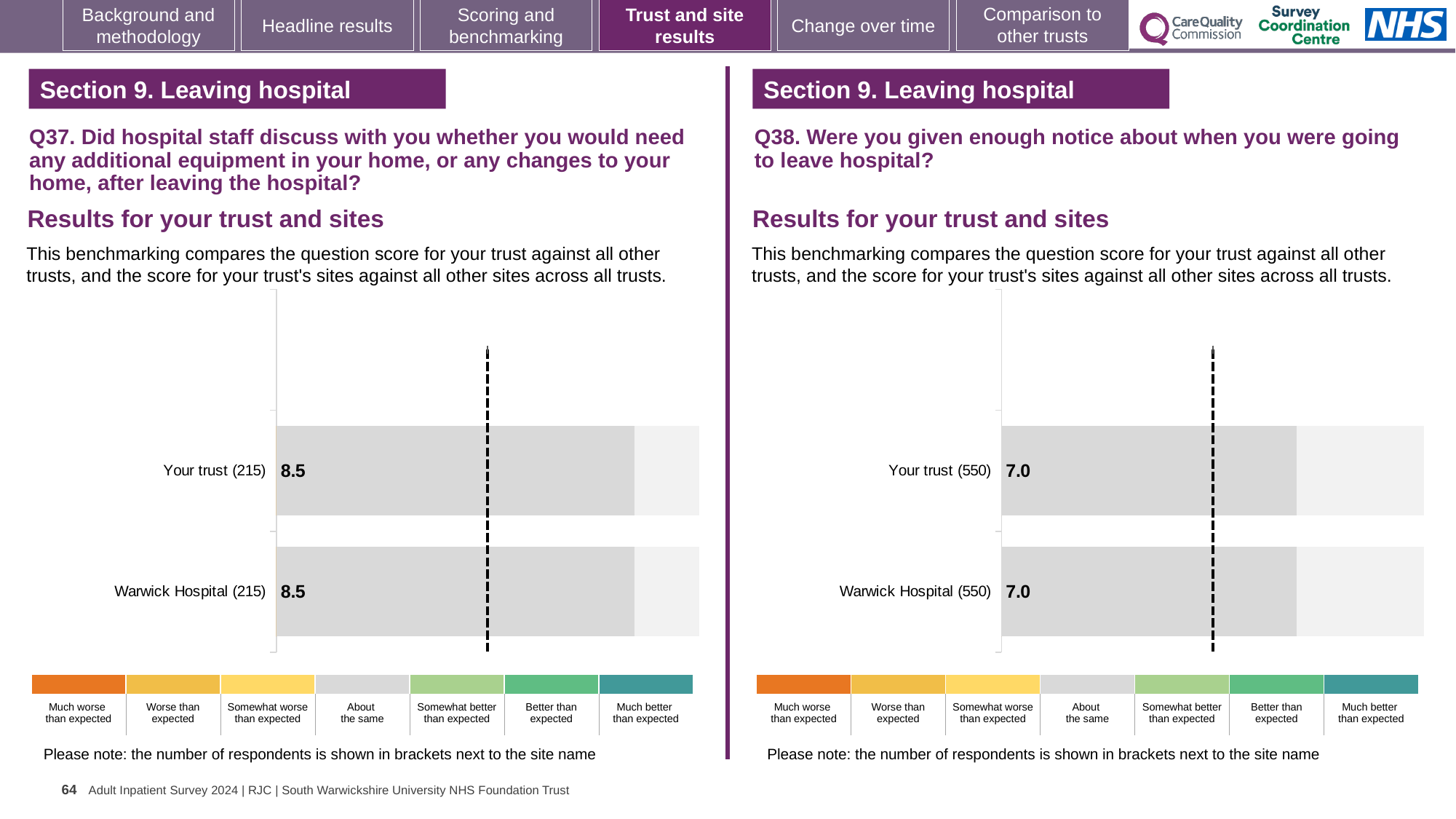
In the Q37 chart on the left, what is the difference between the score for Your trust and the score for Warwick Hospital? 0.0 In the Q38 chart on the right, how many respondents are shown in brackets next to Warwick Hospital? 550 In the Q38 chart on the right, what is the score for Warwick Hospital? 7.0 In the Q38 chart on the right, is the score for Your trust greater or less than 8.5? less In the Q38 chart on the right, what is the score for Your trust? 7.0 In the Q37 chart on the left, what is the score for Your trust? 8.5 In the Q37 chart on the left, how many respondents are shown in brackets next to Your trust? 215 How many bars are plotted in the Q38 chart on the right? 2 Which is larger: the Your trust score in the Q37 chart on the left or the Your trust score in the Q38 chart on the right? Q37 chart (8.5) In the Q37 chart on the left, what is the score for Warwick Hospital? 8.5 What kind of chart is the Q37 chart on the left? Bar chart